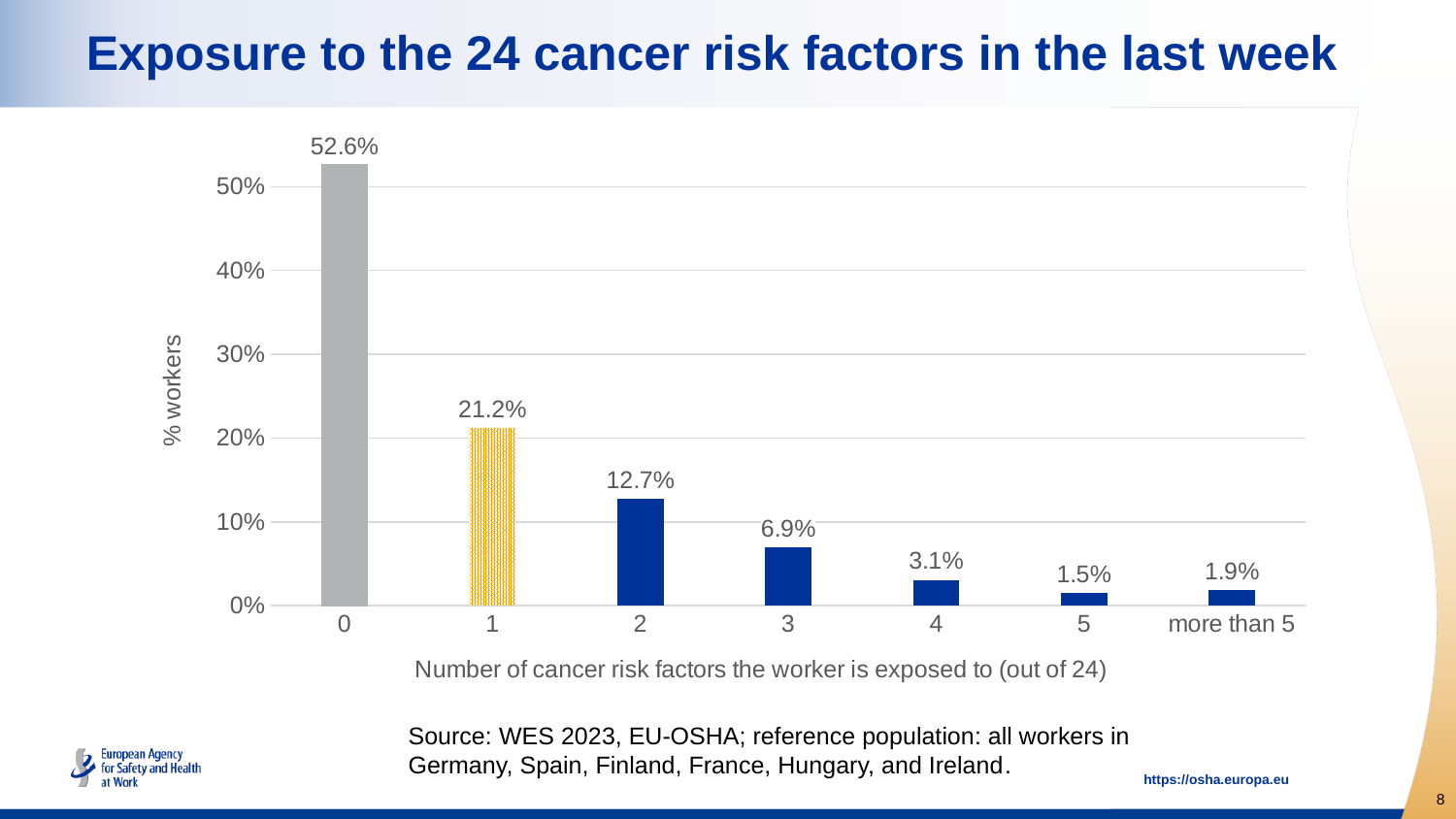
Which category has the highest percentage of workers? 0 Which category has the lowest percentage of workers? 5 What is the value for workers exposed to 2 cancer risk factors? 12.7% What kind of chart is shown on the slide? bar chart What percentage of workers are exposed to 0 cancer risk factors? 52.6% Do the values rise or fall from category 0 to category 5 along the x axis? fall Which is larger, the value for 4 risk factors or the value for more than 5 risk factors? 4 What is the label of the y axis? % workers Is the value for 1 cancer risk factor greater or less than 20%? greater How many categories are shown on the x axis? 7 What percentage of workers are exposed to more than 5 cancer risk factors? 1.9% What is the difference between the values for 1 and 2 cancer risk factors? 8.5%